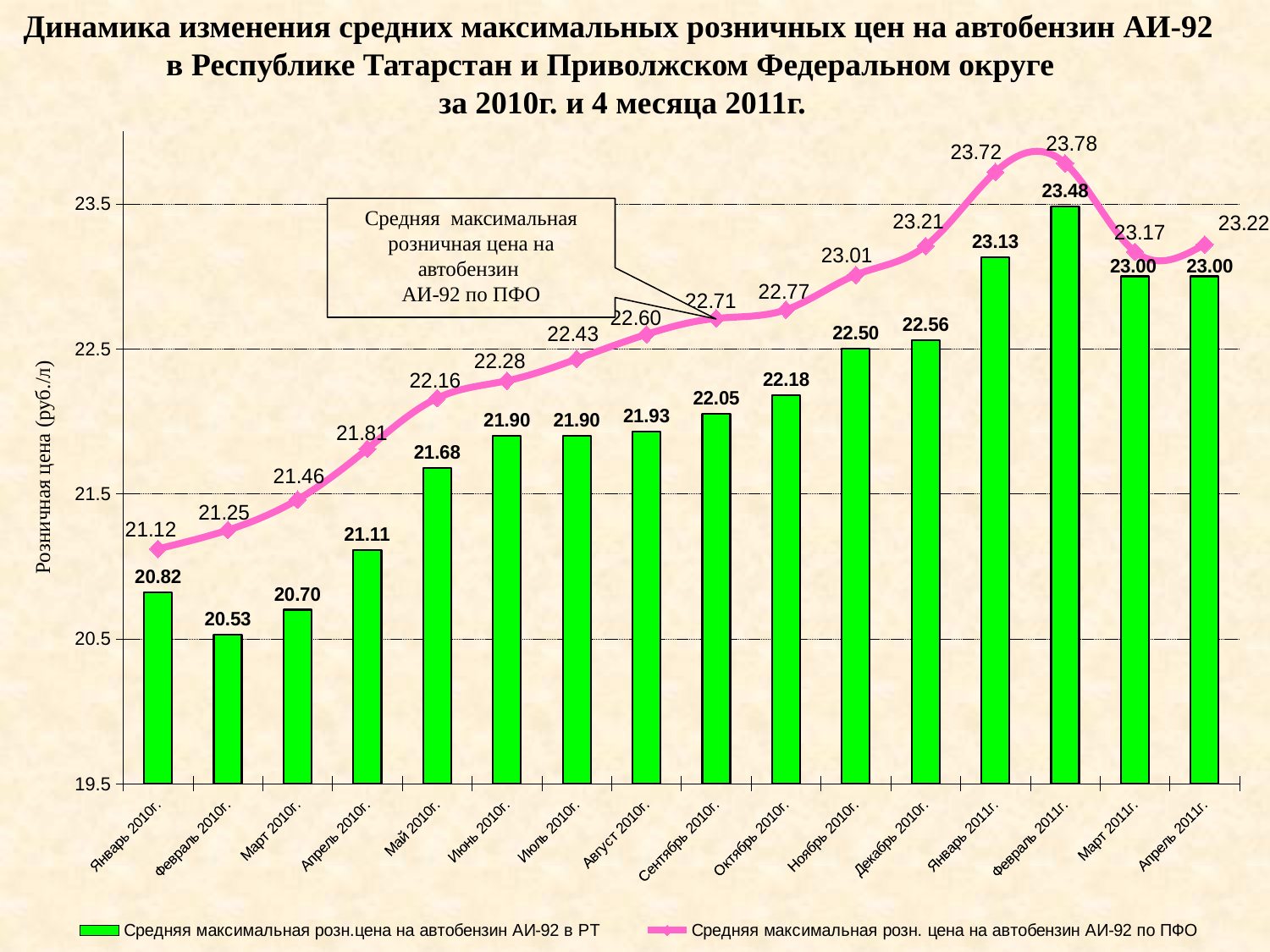
Do the bar values generally rise or fall from Январь 2010г. to Февраль 2011г.? rise What kinds of chart are combined on this slide? a bar chart and a line chart In which month does the line series (price in ПФО) reach its highest value? Февраль 2011г. In which month is the bar series (price in RT) lowest? Февраль 2010г. What is the label of the y axis? Розничная цена (руб./л) Which is larger for Апрель 2011г.: the RT bar value or the ПФО line value? the ПФО line value (23.22) What is the average maximum retail price of AI-92 gasoline in ПФО (line series) for Январь 2010г.? 21.12 What is the value of the bar for Май 2010г.? 21.68 What is the difference between the ПФО line value and the RT bar value for Декабрь 2010г.? 0.65 How many months are shown on the x axis? 16 What is the average maximum retail price of AI-92 gasoline in RT (bar series) for Февраль 2011г.? 23.48 How many series does the legend list? 2